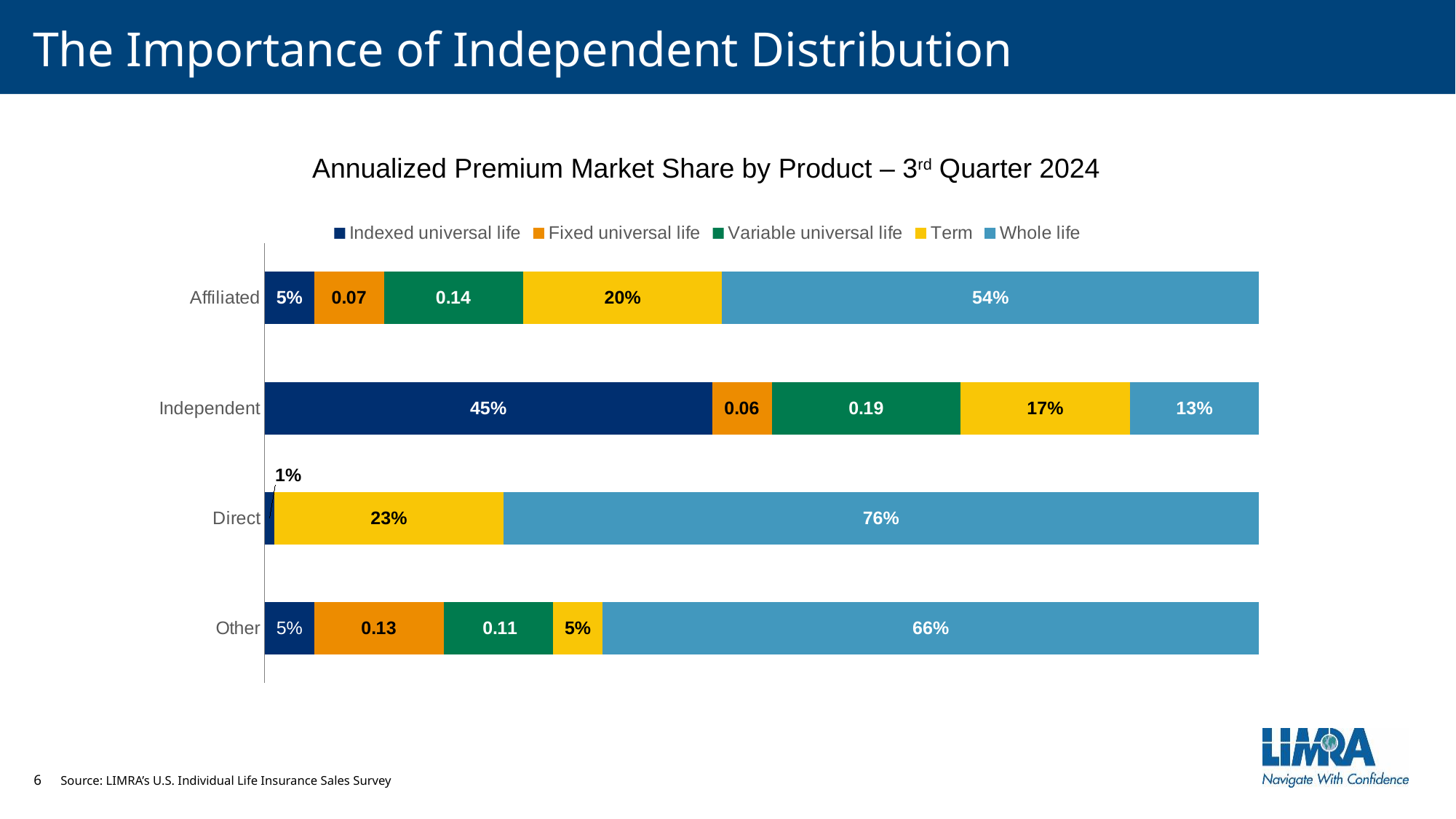
What is the Indexed universal life share for the Direct channel? 1% Which distribution channel has the highest Whole life share? Direct Which distribution channel has the lowest Whole life share? Independent What is the difference between the Whole life share for Direct and for Affiliated? 22 percentage points What value is shown for Fixed universal life in the Other channel? 0.13 What value is shown for Variable universal life in the Independent channel? 0.19 Which channel has a larger Term share, Affiliated or Independent? Affiliated How many distribution channels are shown on the chart? 4 What is the Whole life market share for the Affiliated channel? 54% How many product series does the legend list? 5 What is the Indexed universal life market share for the Independent channel? 45% What type of chart is shown on the slide? Stacked bar chart